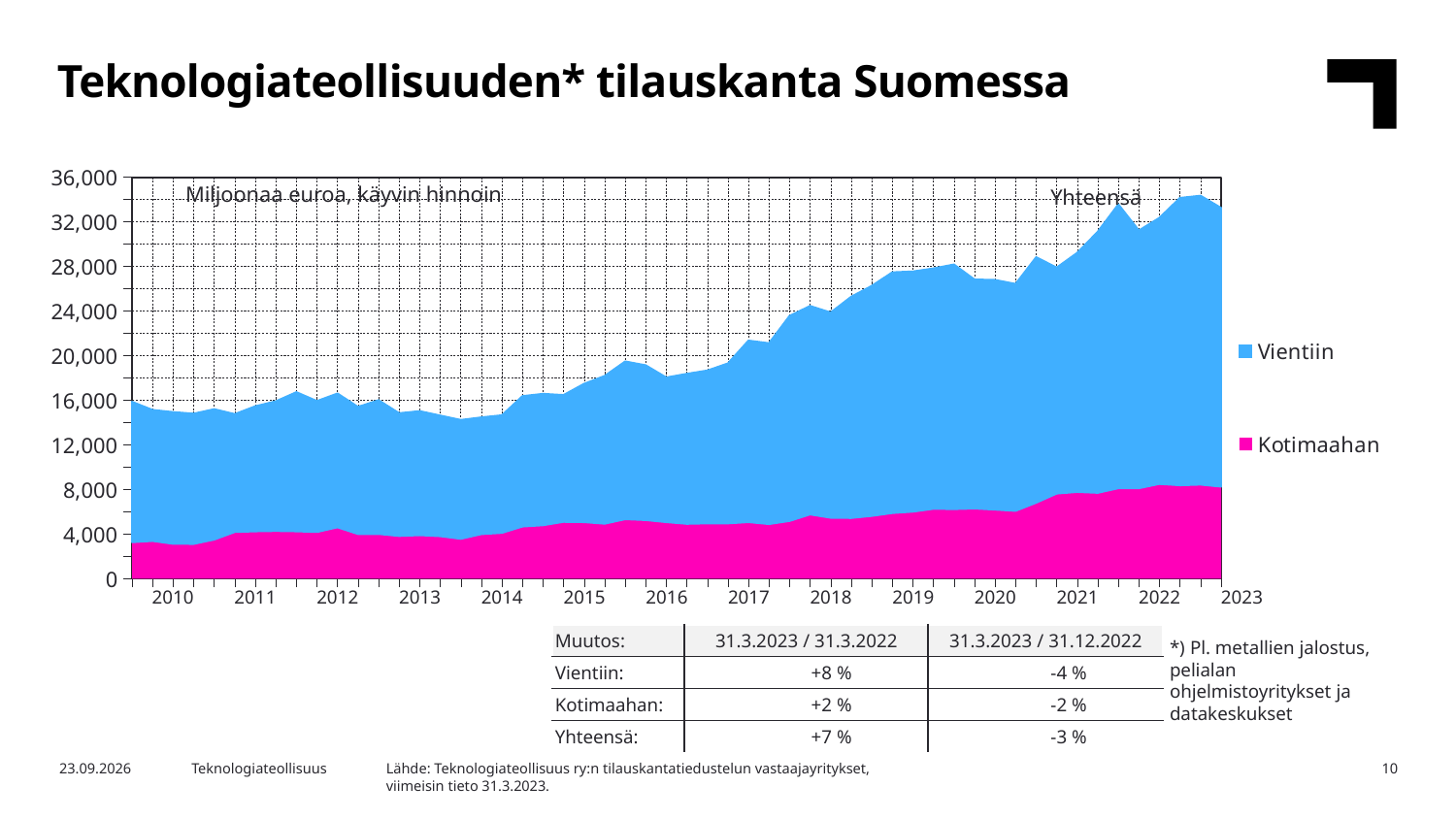
Is the Kotimaahan value at the start of 2010 greater or less than 4,000? less Is the total (Yhteensä) value at the start of 2010 greater or less than 20,000? less Is the total (Yhteensä) value at its peak in 2022 greater or less than 32,000? greater How many series does the chart legend list? 2 How many year labels are shown on the x axis? 14 What kind of chart is shown on the slide? Stacked area chart Does the total order book (Yhteensä) generally rise or fall from 2010 to 2023? rise What are the two series named in the chart legend? Vientiin and Kotimaahan What unit label is printed inside the chart area? Miljoonaa euroa, käyvin hinnoin Which series is larger in 2021, Vientiin or Kotimaahan? Vientiin